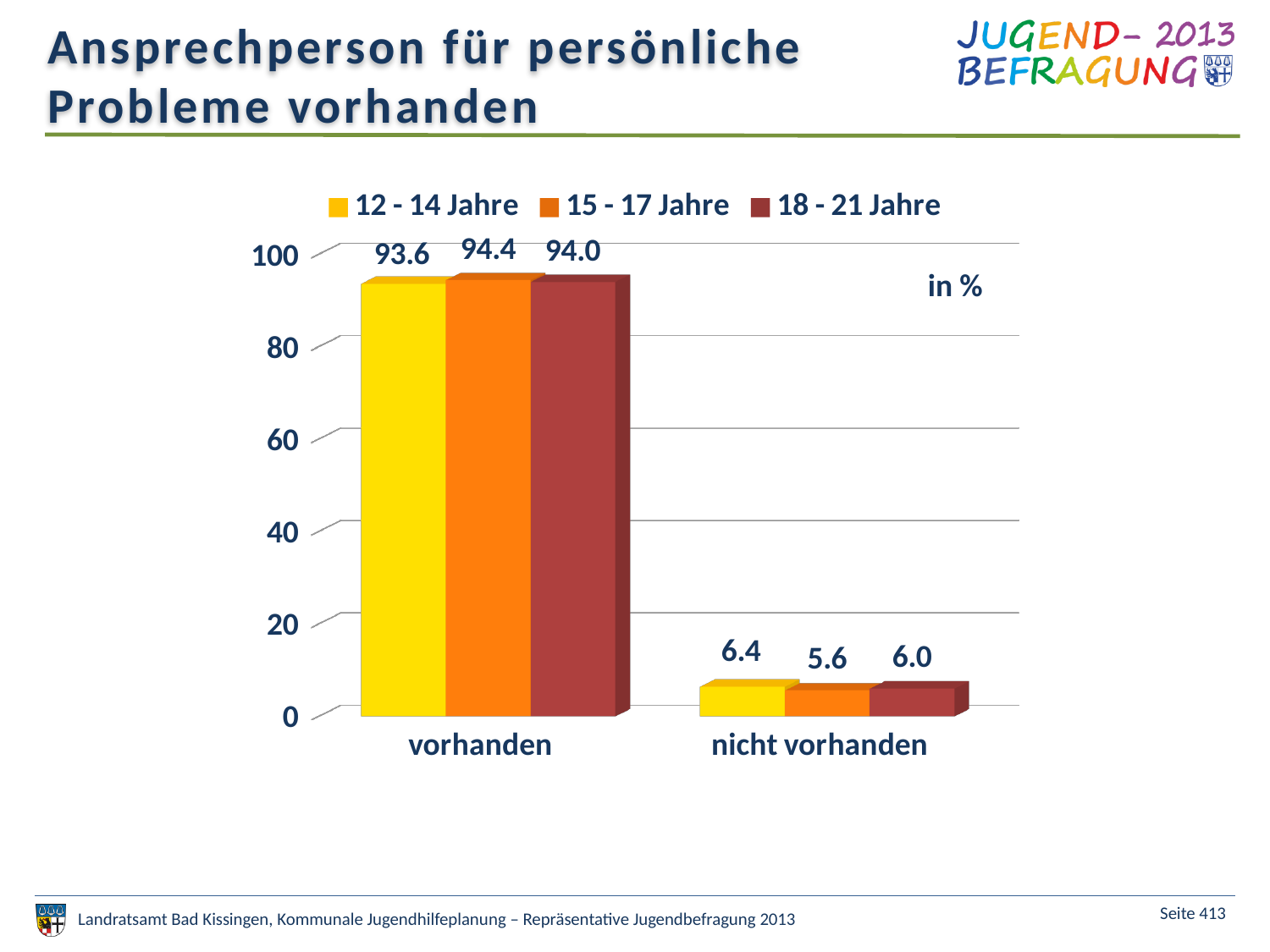
What is the value for the 18 - 21 Jahre series in the vorhanden category? 94.0 How many series does the legend list? 3 Is the value for 18 - 21 Jahre in the nicht vorhanden category greater or less than 20? less What unit is indicated for the values in the chart? in % Which age group has the highest value in the vorhanden category? 15 - 17 Jahre What kind of chart is shown on the slide? bar chart Which age group has the lowest value in the nicht vorhanden category? 15 - 17 Jahre How many categories are shown on the x axis? 2 Which is larger: the 12 - 14 Jahre value for vorhanden or the 18 - 21 Jahre value for vorhanden? 18 - 21 Jahre What is the value for the 15 - 17 Jahre series in the nicht vorhanden category? 5.6 What is the difference between the 12 - 14 Jahre and 15 - 17 Jahre values in the nicht vorhanden category? 0.8 What is the value for the 12 - 14 Jahre series in the vorhanden category? 93.6